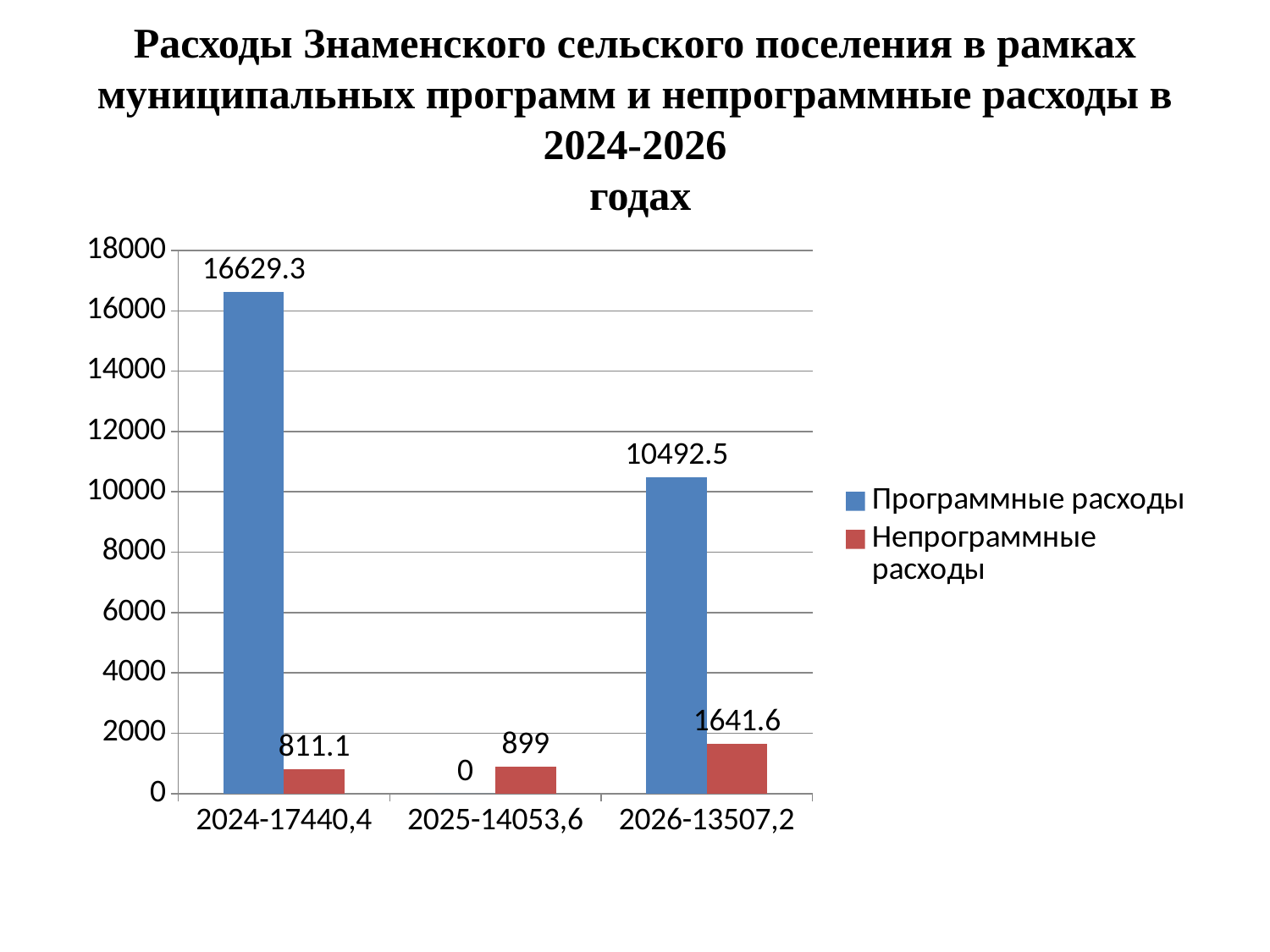
What kind of chart is shown on the slide? bar chart What is the value of Программные расходы for the category 2024-17440,4? 16629.3 Is the value of Программные расходы for 2026-13507,2 greater or less than 10000? greater What is the value of Непрограммные расходы for the category 2026-13507,2? 1641.6 Which category has the lowest value for Программные расходы? 2025-14053,6 How many series does the legend list? 2 What is the difference between Программные расходы for 2024-17440,4 and for 2026-13507,2? 6136.8 Which is larger: Непрограммные расходы for 2024-17440,4 or for 2025-14053,6? 2025-14053,6 What is the value of Непрограммные расходы for the category 2025-14053,6? 899 How many categories are shown on the x axis? 3 Which category has the highest value for Непрограммные расходы? 2026-13507,2 What is the value of Программные расходы for the category 2025-14053,6? 0